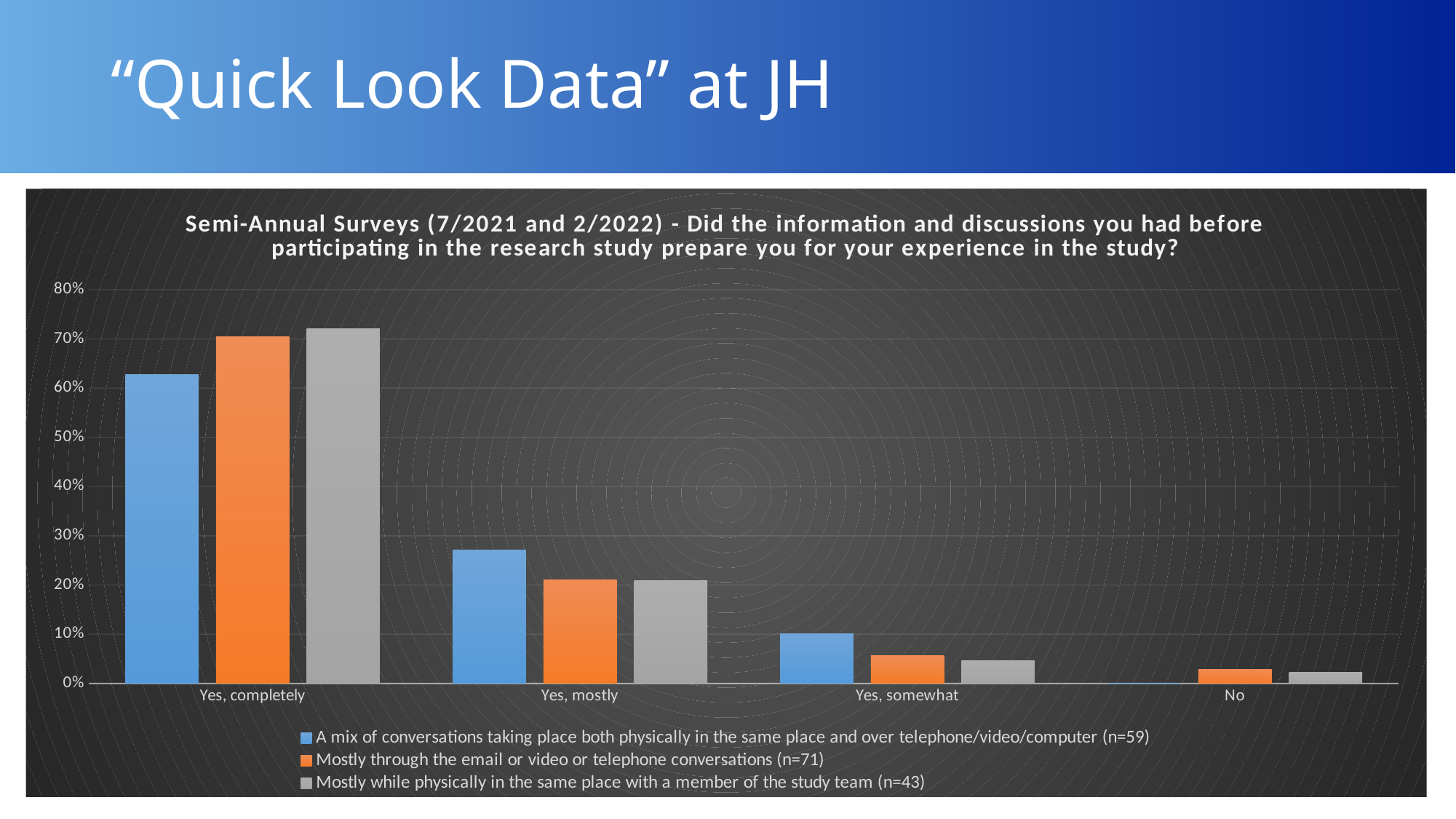
For 'Yes, completely', which is larger: the 'A mix of conversations...' (n=59) series or the 'Mostly through the email or video or telephone conversations (n=71)' series? Mostly through the email or video or telephone conversations (n=71) Do the values for the 'Mostly while physically in the same place with a member of the study team (n=43)' series rise or fall moving from 'Yes, completely' to 'No'? fall Which response category has the lowest value for the 'Mostly through the email or video or telephone conversations (n=71)' series? No Which response category has the highest value for the 'A mix of conversations taking place both physically in the same place and over telephone/video/computer (n=59)' series? Yes, completely What colour represents the 'Mostly through the email or video or telephone conversations (n=71)' series? Orange Is the value for 'Yes, mostly' in the 'A mix of conversations...' (n=59) series greater or less than 30%? less How many response categories are shown on the x axis? 4 Is the value for 'Yes, somewhat' in the 'Mostly through the email or video or telephone conversations (n=71)' series greater or less than 10%? less Is the value for 'Yes, completely' in the 'A mix of conversations...' (n=59) series greater or less than 50%? greater For 'Yes, mostly', which is larger: the 'A mix of conversations...' (n=59) series or the 'Mostly through the email or video or telephone conversations (n=71)' series? A mix of conversations taking place both physically in the same place and over telephone/video/computer (n=59) What kind of chart is shown on the slide? Bar chart How many series does the legend list? 3